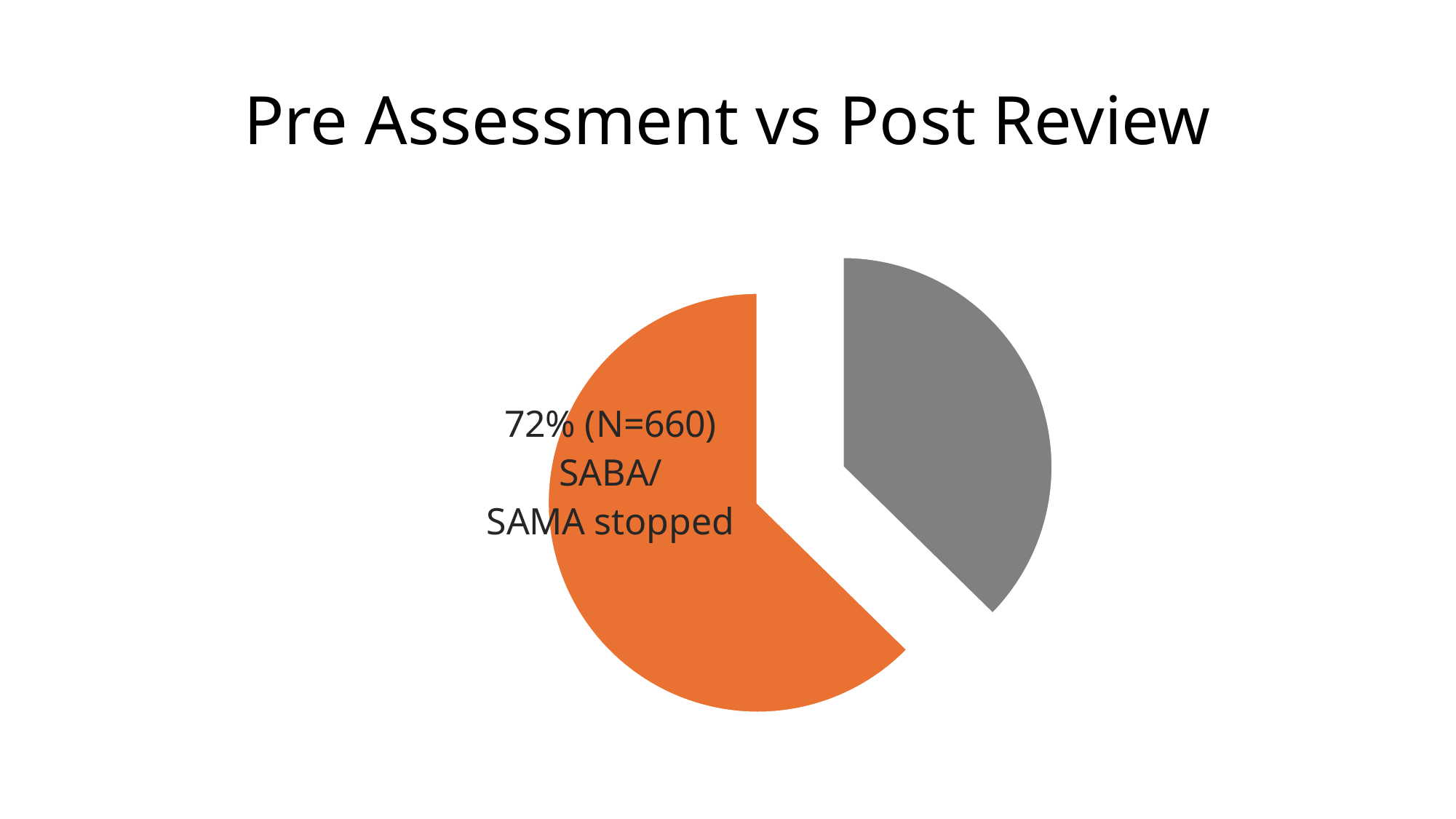
Is the share of the gray slice greater or less than 50%? less What is the N value printed for the SABA/SAMA stopped slice? N=660 What kind of chart is shown on the slide? Pie chart Which slice of the pie chart is the largest? SABA/SAMA stopped What colour is the slice labelled SABA/SAMA stopped? Orange Which is larger, the orange slice or the gray slice? The orange slice What percentage share is shown for the SABA/SAMA stopped slice? 72% How many slices does the pie chart have? 2 What is the title of the slide? Pre Assessment vs Post Review What is the full data label printed on the orange slice? 72% (N=660) SABA/SAMA stopped